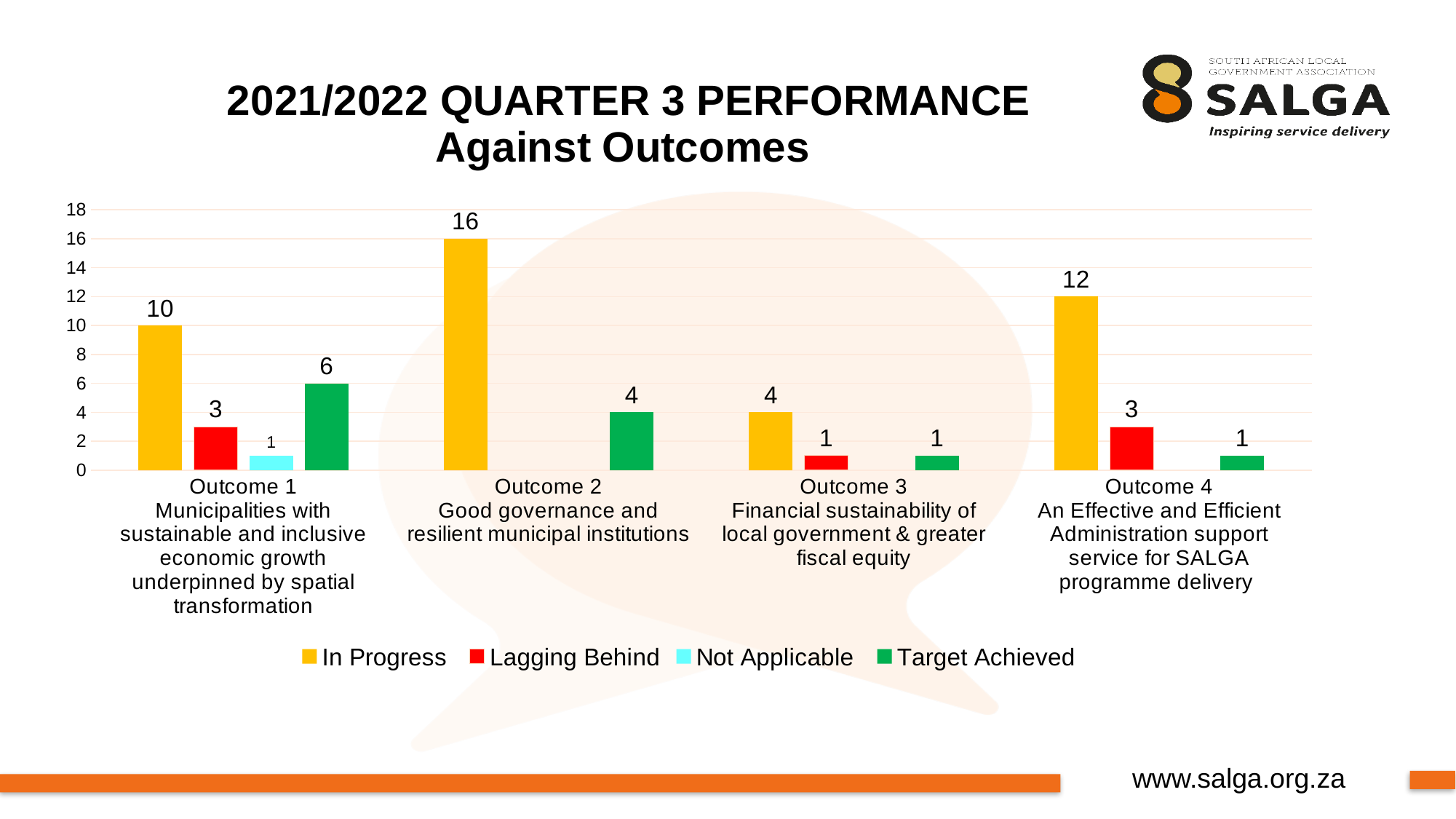
Which outcome has the highest In Progress value? Outcome 2 What kind of chart is shown on the slide? Bar chart What is the In Progress value for Outcome 2? 16 What is the Not Applicable value for Outcome 1? 1 What is the difference between the In Progress values for Outcome 2 and Outcome 4? 4 How many outcome categories are shown on the x axis? 4 What is the Target Achieved value for Outcome 1? 6 What is the Lagging Behind value for Outcome 4? 3 Which outcome has the lowest In Progress value? Outcome 3 How many series does the legend list? 4 Which colour represents the Target Achieved series? Green Which is larger, the Target Achieved value for Outcome 1 or for Outcome 2? Outcome 1